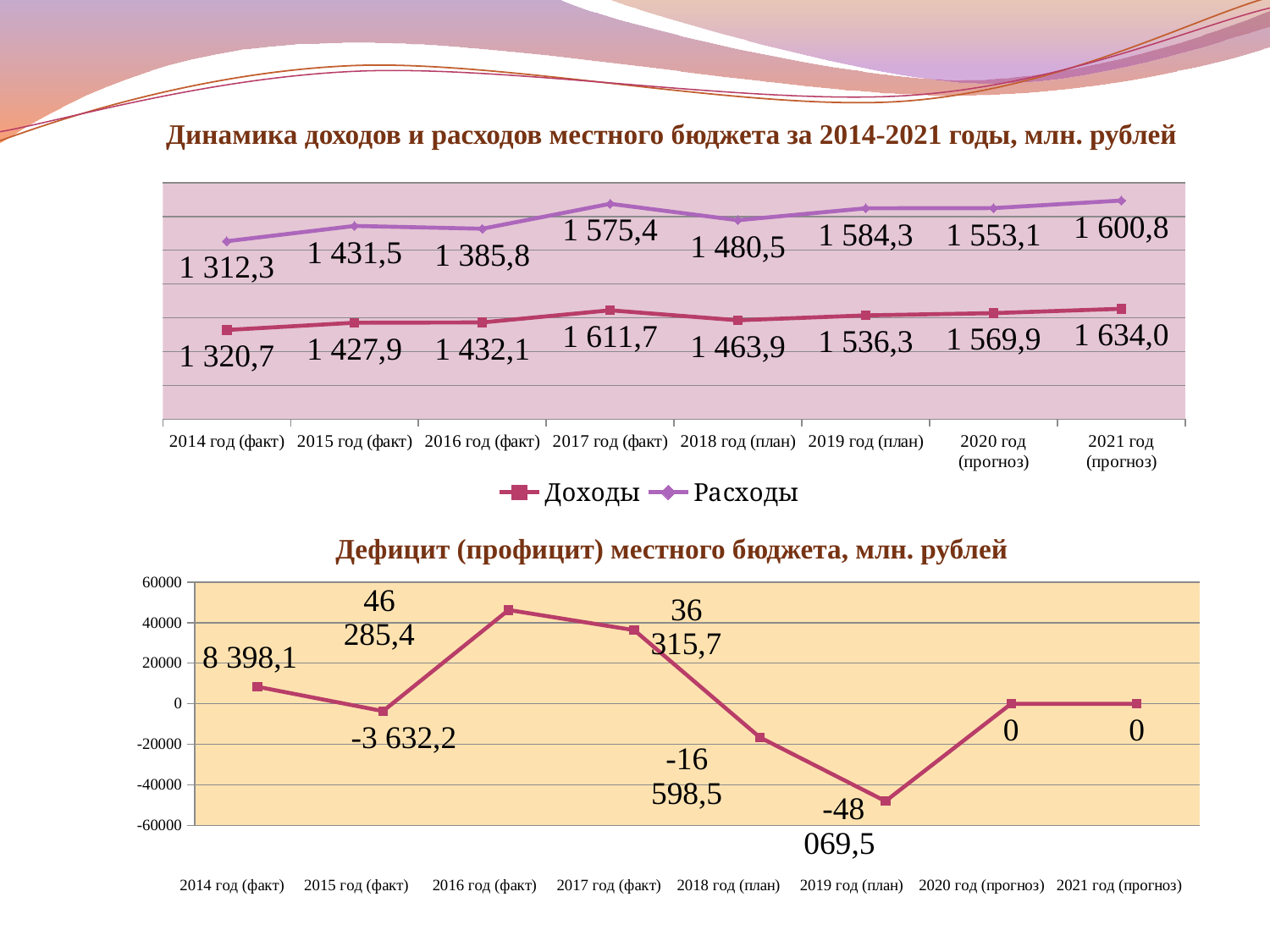
In the top chart 'Динамика доходов и расходов местного бюджета', which year has the highest value of Доходы? 2021 год (прогноз) In the top chart 'Динамика доходов и расходов местного бюджета', what is the value of Расходы for 2014 год (факт)? 1 312,3 In the top chart 'Динамика доходов и расходов местного бюджета', which is larger for 2016 год (факт): Доходы or Расходы? Доходы In the top chart 'Динамика доходов и расходов местного бюджета', what is the value of Расходы for 2021 год (прогноз)? 1 600,8 In the top chart 'Динамика доходов и расходов местного бюджета', what is the difference between Доходы and Расходы for 2019 год (план)? 48,0 In the top chart 'Динамика доходов и расходов местного бюджета', what is the value of Доходы for 2017 год (факт)? 1 611,7 In the top chart 'Динамика доходов и расходов местного бюджета', how many series does the legend list? 2 In the bottom chart 'Дефицит (профицит) местного бюджета', how many years are plotted on the x axis? 8 In the top chart 'Динамика доходов и расходов местного бюджета', which year has the lowest value of Расходы? 2014 год (факт) What kind of chart is the bottom chart 'Дефицит (профицит) местного бюджета'? Line chart In the bottom chart 'Дефицит (профицит) местного бюджета', which year has the highest value? 2016 год (факт) In the bottom chart 'Дефицит (профицит) местного бюджета', what is the value for 2019 год (план)? -48 069,5